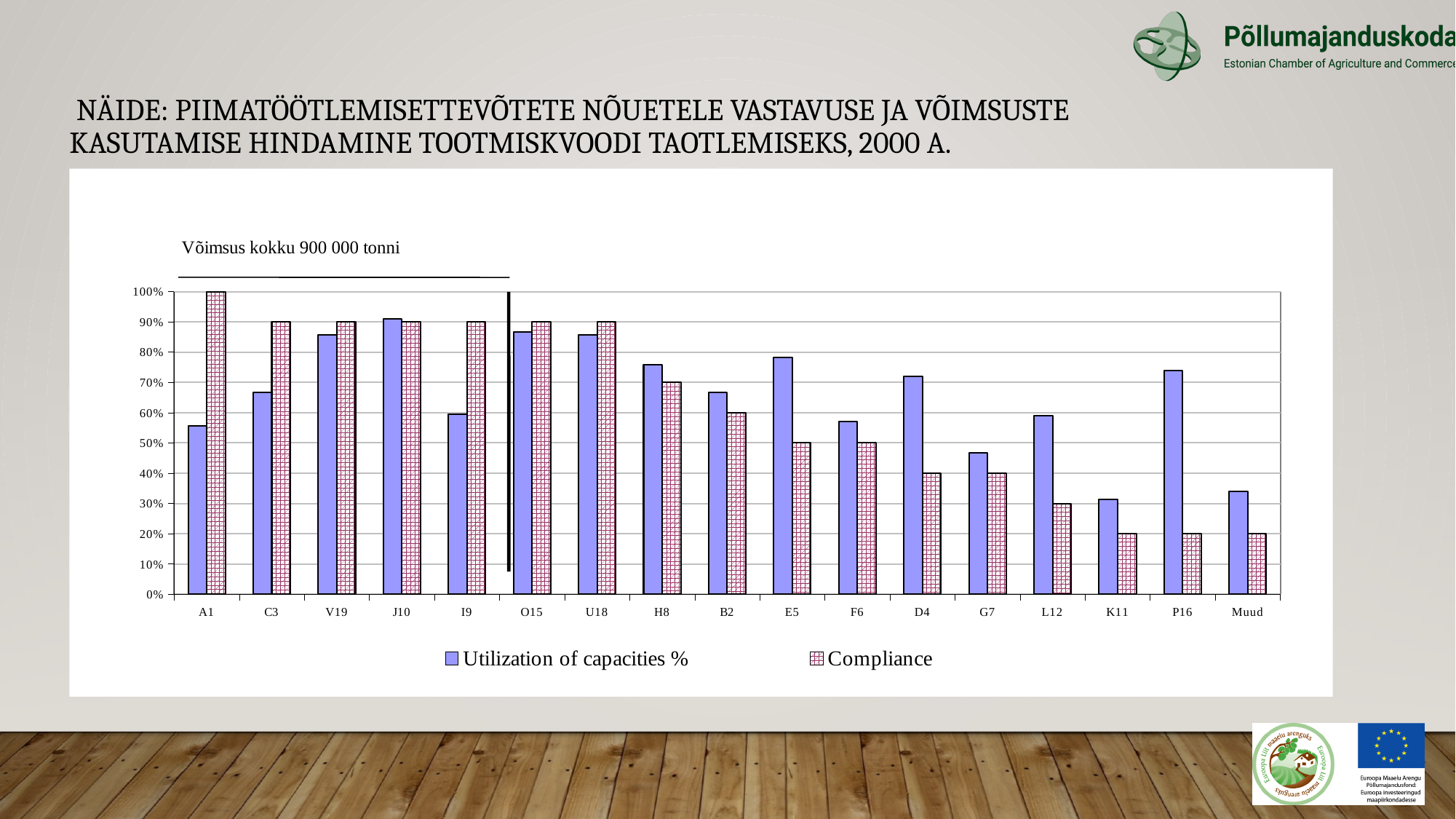
What is the difference between the Compliance values for A1 and K11? 80% What text is written above the chart? Võimsus kokku 900 000 tonni For A1, which is larger: Utilization of capacities % or Compliance? Compliance Is the Utilization of capacities % value for K11 greater or less than 40%? less How many categories are shown on the x axis? 17 Which category has the highest Compliance value? A1 What kind of chart is shown on the slide? bar chart Is the Utilization of capacities % value for J10 greater or less than 80%? greater What is the Compliance value for H8? 70% What is the Compliance value for A1? 100% What is the Compliance value for Muud? 20% How many series does the legend list? 2